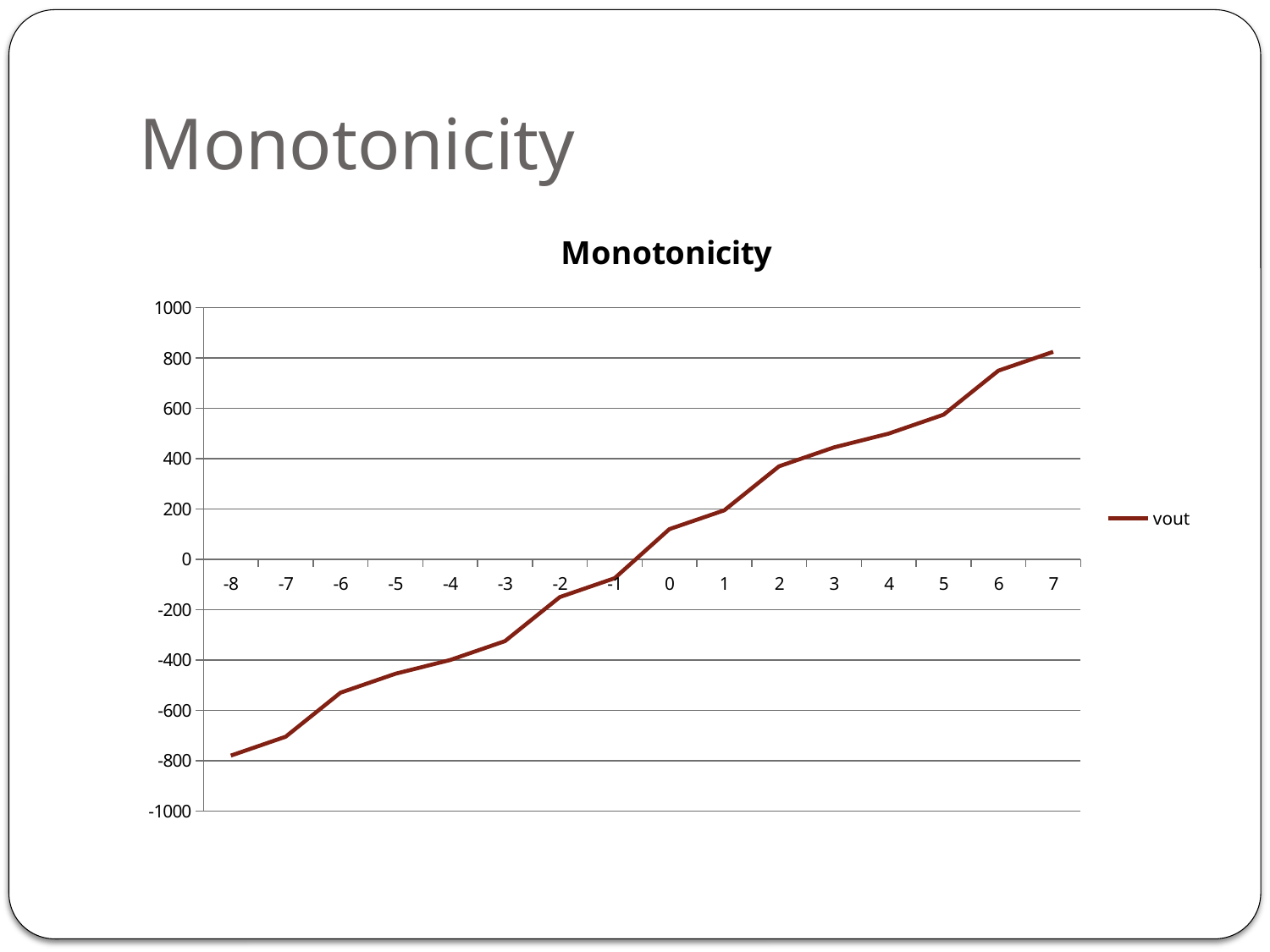
At which x value is vout highest? 7 What is the title of the chart? Monotonicity Is the value of vout at x = -8 greater or less than -600? less Is the value of vout at x = 6 greater or less than 600? greater How many series does the legend list? 1 At which x value is vout lowest? -8 What kind of chart is shown on the slide? line chart How many points are plotted along the x axis? 16 Do the values of vout rise or fall as the x axis goes from -8 to 7? rise What is the name of the series shown in the legend? vout Is the value of vout at x = 0 greater or less than 0? greater Which is larger, the value of vout at x = 2 or at x = -2? x = 2